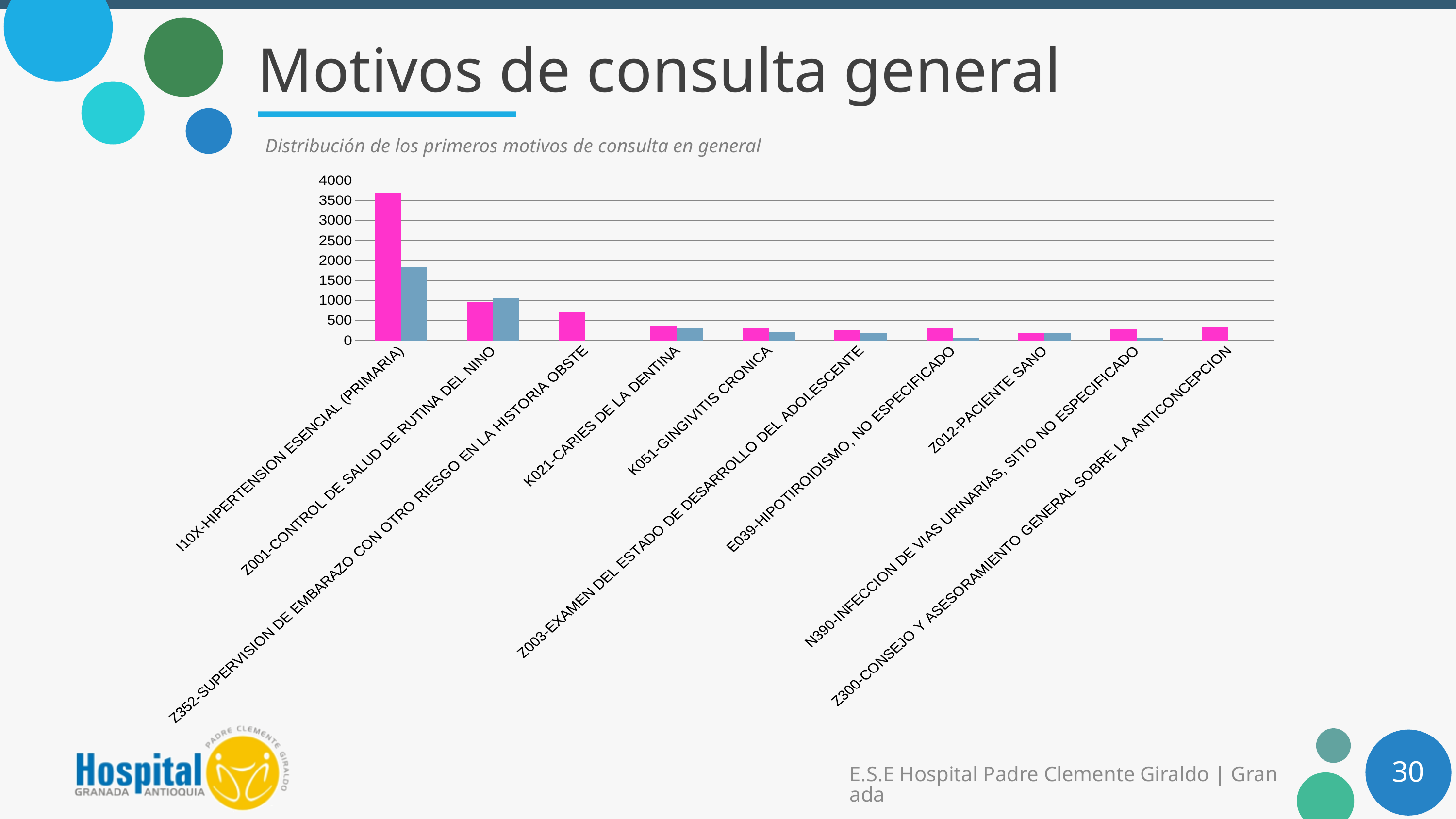
What kind of chart is shown on the slide? bar chart Is the pink bar for Z352-SUPERVISION DE EMBARAZO CON OTRO RIESGO EN LA HISTORIA OBSTE greater or less than 500? greater Is the pink bar for I10X-HIPERTENSION ESENCIAL (PRIMARIA) greater or less than 3500? greater Is the pink bar for Z352-SUPERVISION DE EMBARAZO CON OTRO RIESGO EN LA HISTORIA OBSTE greater or less than 1000? less Which category has the highest bar in the chart? I10X-HIPERTENSION ESENCIAL (PRIMARIA) How many categories (consultation reasons) are shown on the x axis? 10 Which has a larger pink bar, I10X-HIPERTENSION ESENCIAL (PRIMARIA) or Z001-CONTROL DE SALUD DE RUTINA DEL NINO? I10X-HIPERTENSION ESENCIAL (PRIMARIA) For I10X-HIPERTENSION ESENCIAL (PRIMARIA), which bar is larger, the pink one or the blue one? the pink one What is the subtitle printed above the chart? Distribución de los primeros motivos de consulta en general